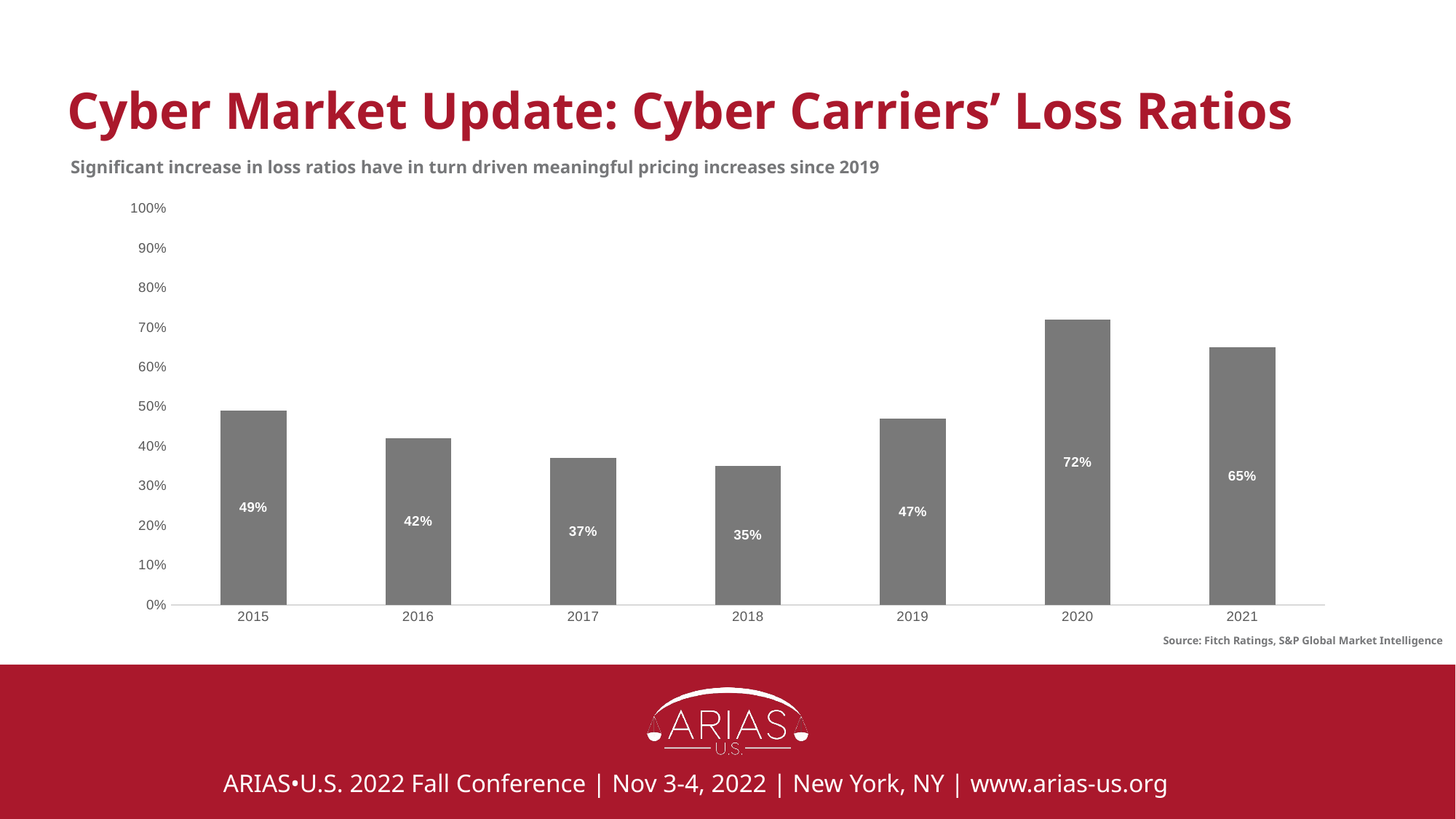
Which year has the lowest loss ratio? 2018 What is the difference between the loss ratios for 2019 and 2018? 12% How many years are shown on the chart? 7 What is the loss ratio for 2018? 35% Do the loss ratios rise or fall from 2018 to 2020? Rise Is the loss ratio for 2021 greater or less than 60%? greater What is the loss ratio for 2020? 72% What is the loss ratio for 2015? 49% Which year has a higher loss ratio, 2016 or 2017? 2016 Which year has the highest loss ratio? 2020 What is the difference between the loss ratios for 2020 and 2021? 7% What kind of chart is shown on the slide? Bar chart